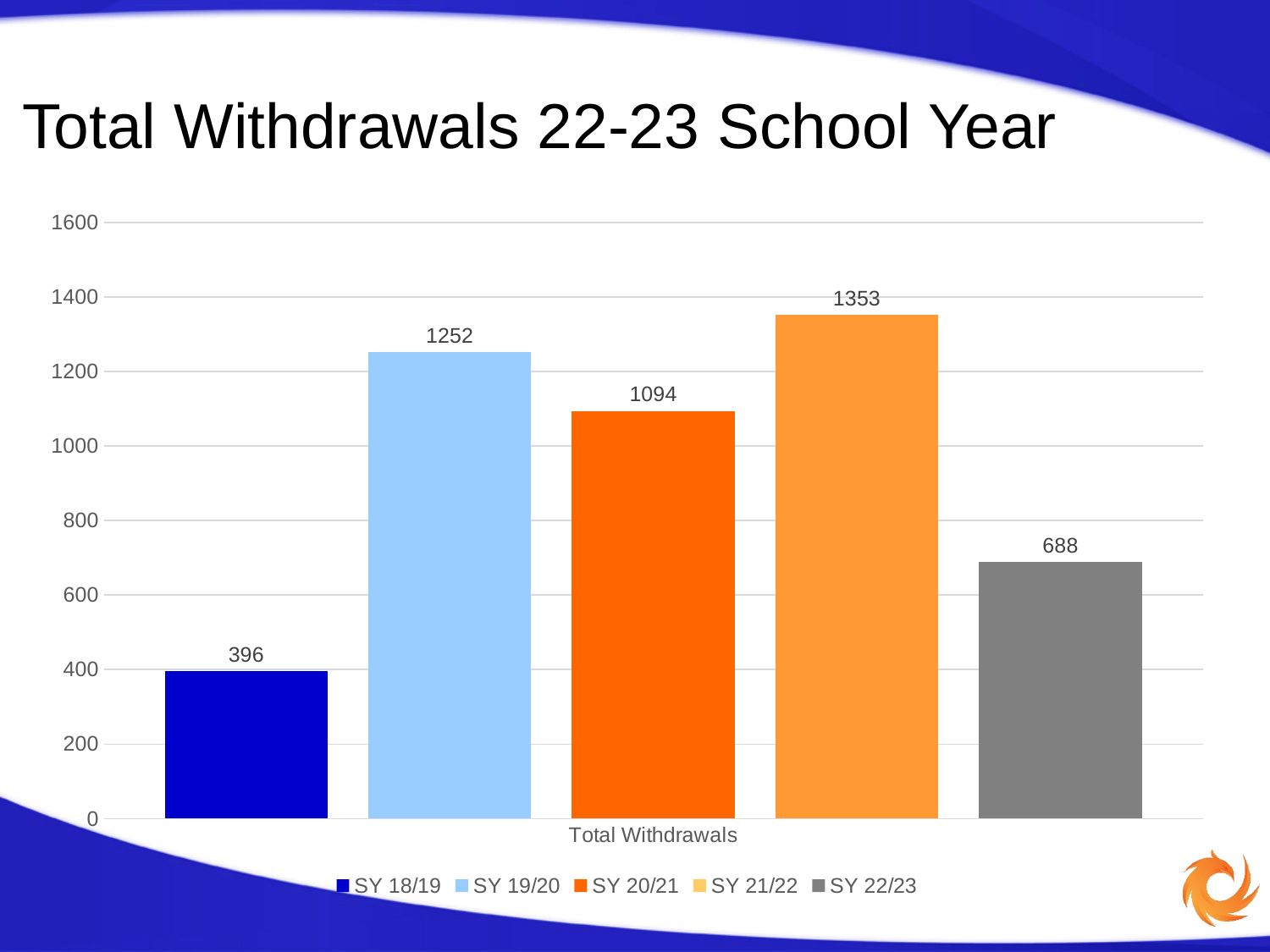
What is the value for SY 21/22? 1353 What is the difference between the values for SY 19/20 and SY 20/21? 158 Which school year has the lowest total withdrawals? SY 18/19 Which is larger, the value for SY 19/20 or the value for SY 20/21? SY 19/20 What is the value for SY 18/19? 396 What kind of chart is shown on the slide? bar chart What is the title of the chart? Total Withdrawals 22-23 School Year Is the value for SY 22/23 greater or less than 800? less What is the difference between the values for SY 21/22 and SY 22/23? 665 How many series does the legend list? 5 Which school year has the highest total withdrawals? SY 21/22 What is the value for SY 22/23? 688